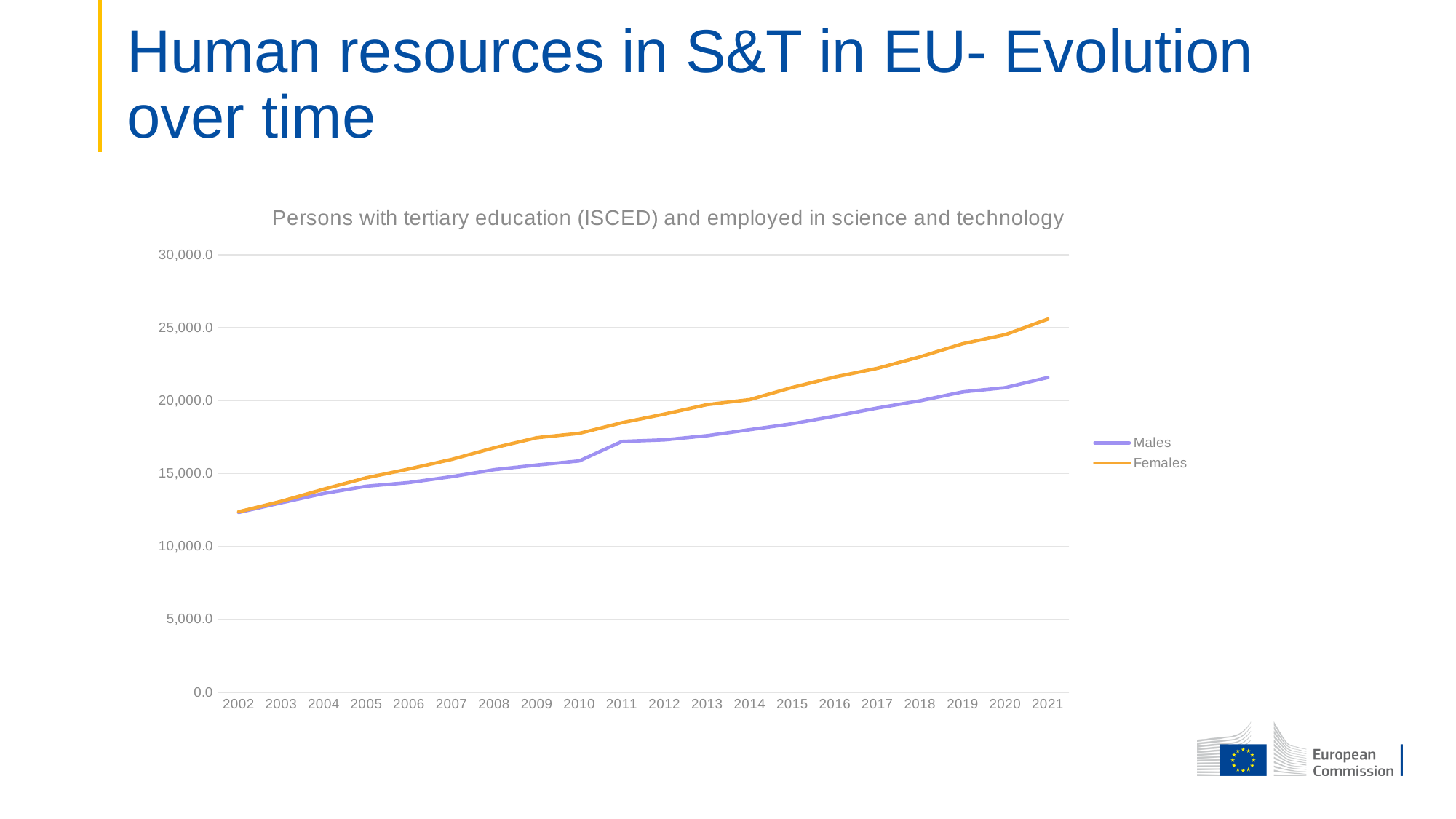
What is the title of the chart? Persons with tertiary education (ISCED) and employed in science and technology Do the values for Males rise or fall from 2002 to 2021? Rise What kind of chart is shown on the slide? Line chart How many series does the legend list? 2 Which colour is used for the Females line? Orange In 2021, which series has the larger value, Males or Females? Females How many years are plotted along the x axis? 20 Is the value for Females in 2009 greater or less than 20,000.0? less Is the value for Females in 2002 greater or less than 15,000.0? less Is the value for Males in 2021 greater or less than 20,000.0? greater Do the values for Females rise or fall from 2002 to 2021? Rise